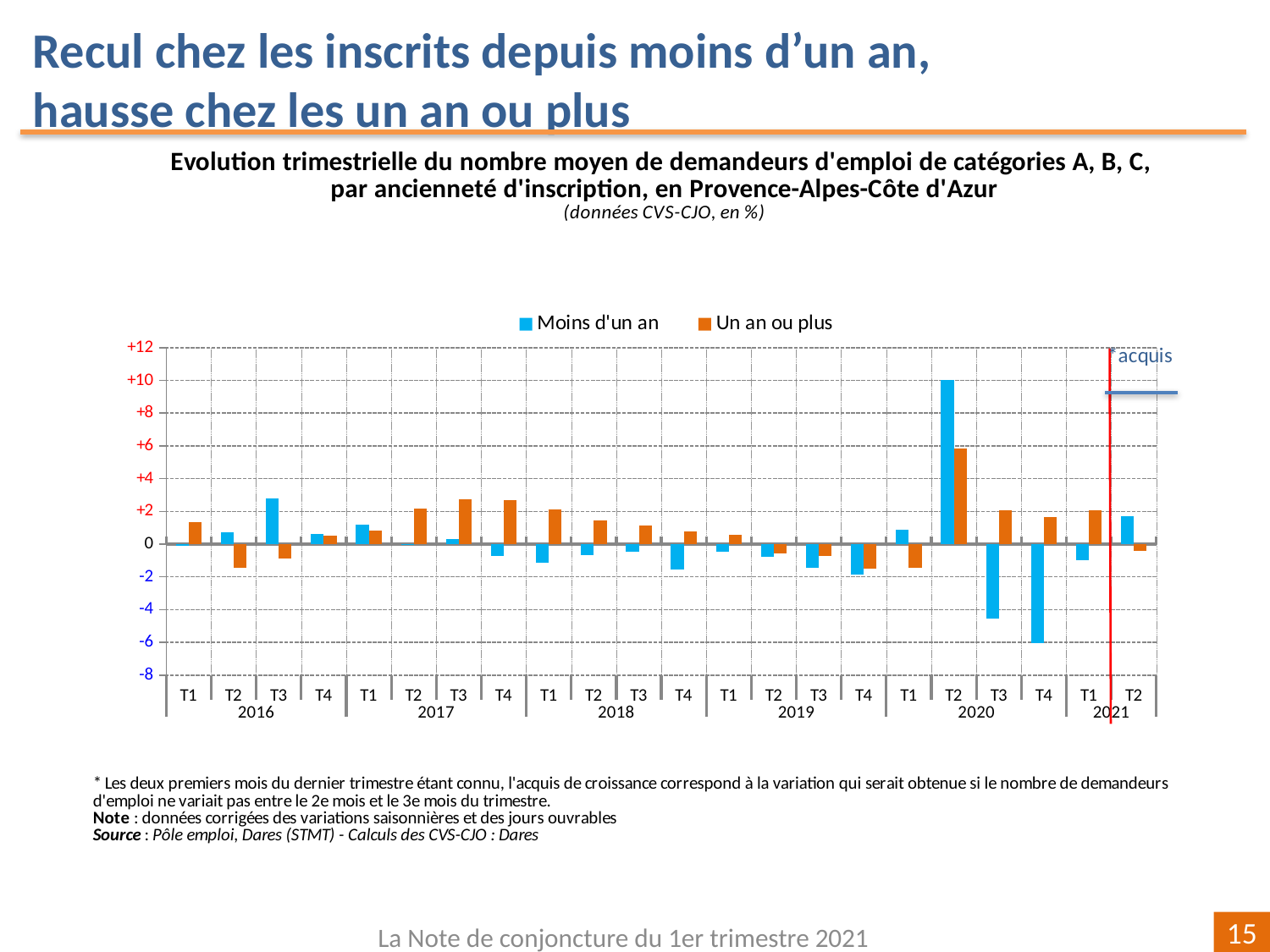
In T2 2020, which series has the larger value, 'Moins d'un an' or 'Un an ou plus'? Moins d'un an Is the value for 'Moins d'un an' in T4 2020 greater or less than -4? less Is the value for 'Moins d'un an' in T2 2020 greater or less than +8? greater In T4 2020, which series has the larger value, 'Moins d'un an' or 'Un an ou plus'? Un an ou plus What kind of chart is shown on the slide? bar chart In which quarter is the value for 'Moins d'un an' lowest? T4 2020 In which quarter is the value for 'Un an ou plus' highest? T2 2020 Is the value for 'Un an ou plus' in T2 2020 greater or less than +4? greater How many series does the legend list? 2 How many quarters are plotted along the x axis? 22 In which quarter is the value for 'Moins d'un an' highest? T2 2020 Which colour represents the 'Un an ou plus' series? orange